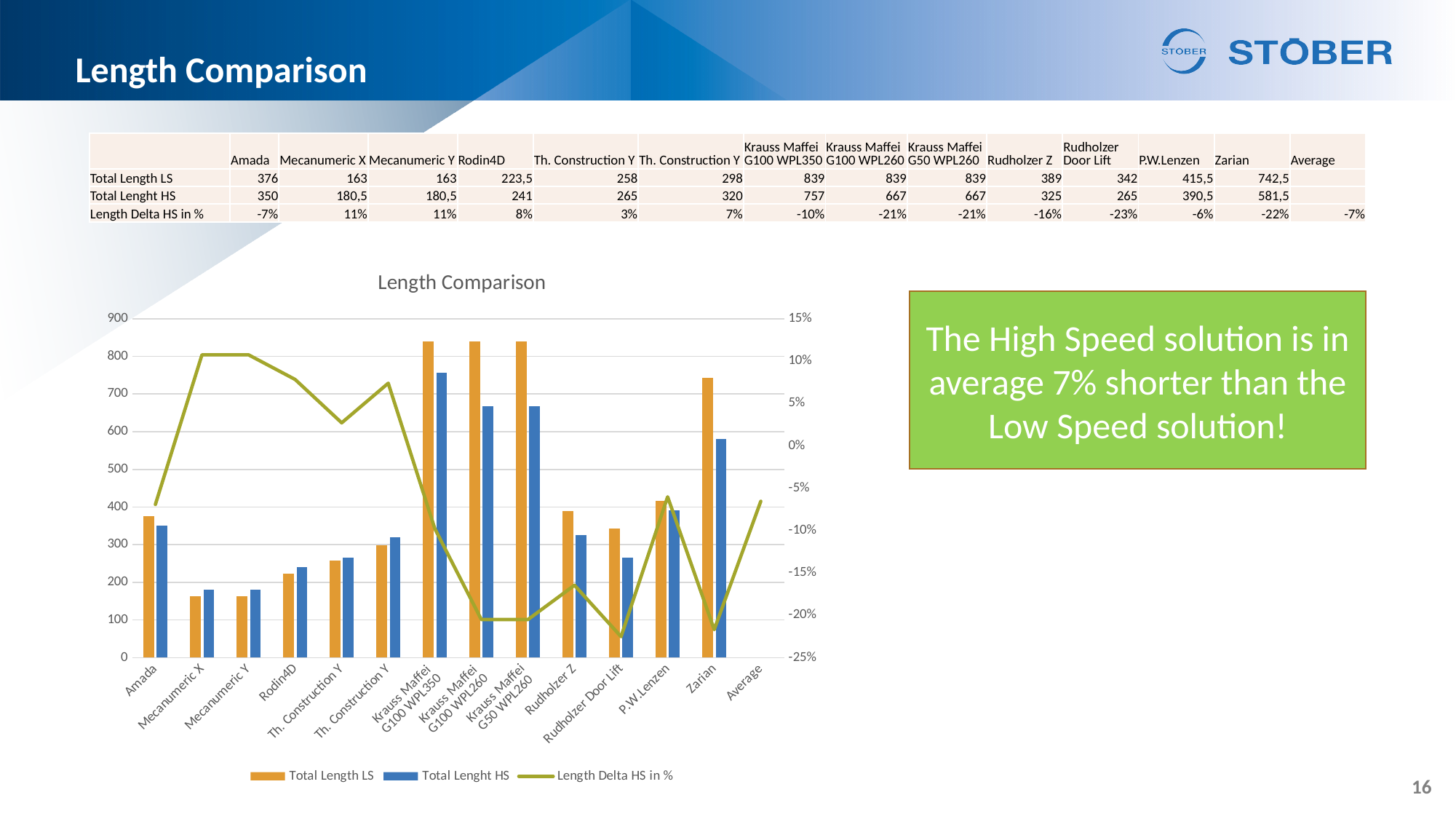
What is the Length Delta HS in % for Rudholzer Z? -16% Which category has the highest Total Lenght HS value? Krauss Maffei G100 WPL350 For Rodin4D, which is larger: Total Length LS or Total Lenght HS? Total Lenght HS How many categories are shown along the x axis of the chart? 14 Which series is plotted as a line in the chart? Length Delta HS in % What is the difference between Total Length LS and Total Lenght HS for Zarian? 161 Is the Total Lenght HS value for Rudholzer Door Lift greater or less than 300? less What is the Total Length LS value for Amada? 376 What is the Total Lenght HS value for Zarian? 581,5 What is the title of the chart? Length Comparison How many series does the chart legend list? 3 What kind of chart is shown on the slide? Combination bar and line chart